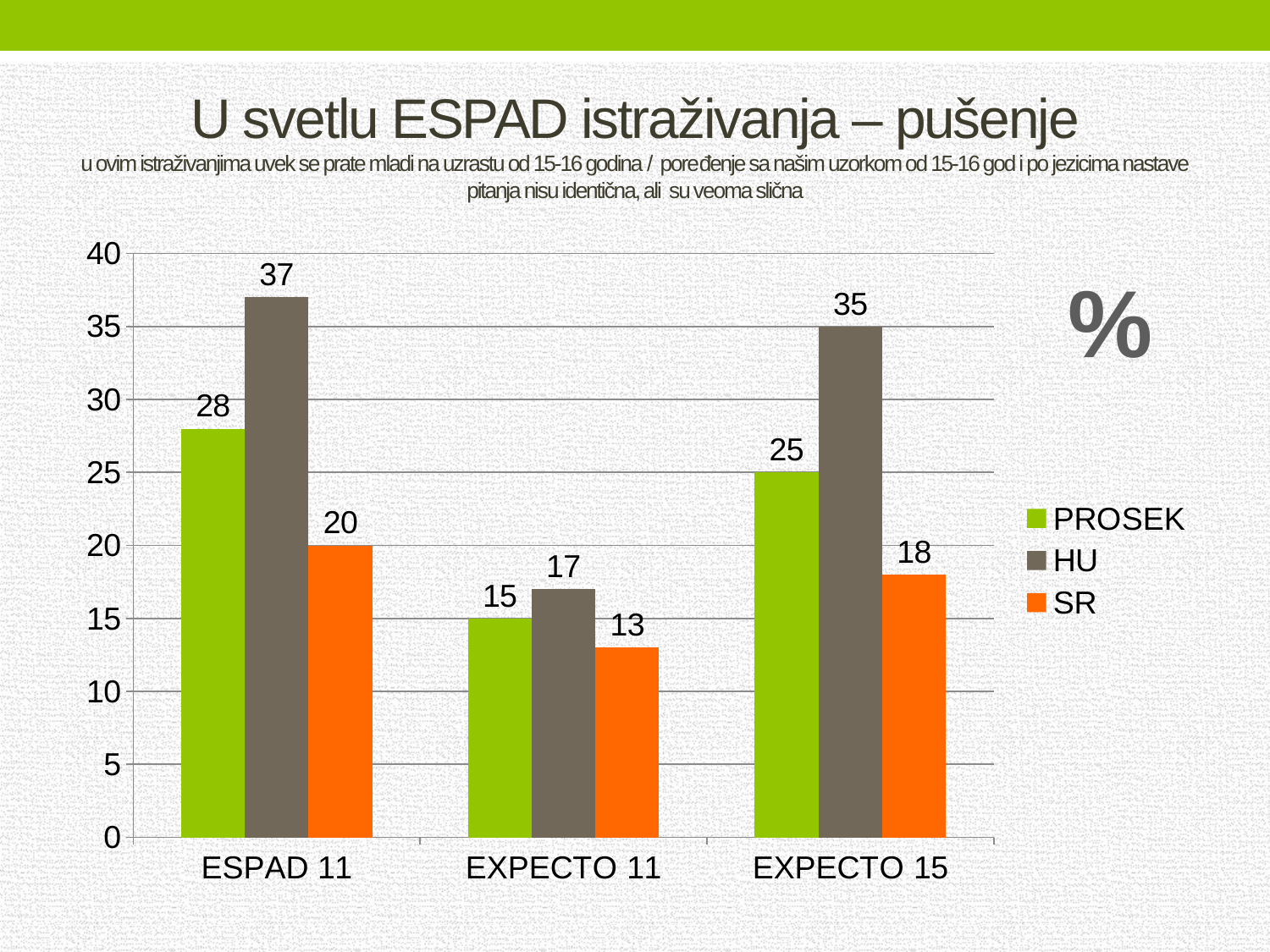
What is the value for PROSEK in the EXPECTO 15 category? 25 What is the difference between the HU and SR values in the EXPECTO 15 category? 17 What colour are the SR bars? orange Which category has the lowest PROSEK value? EXPECTO 11 What are the three series listed in the legend? PROSEK, HU, SR How many categories are shown on the x axis? 3 What is the value for HU in the ESPAD 11 category? 37 What is the value for SR in the EXPECTO 11 category? 13 How many series does the legend list? 3 Which category has the highest HU value? ESPAD 11 What kind of chart is shown on the slide? bar chart Which is larger, the PROSEK value for ESPAD 11 or the PROSEK value for EXPECTO 15? ESPAD 11